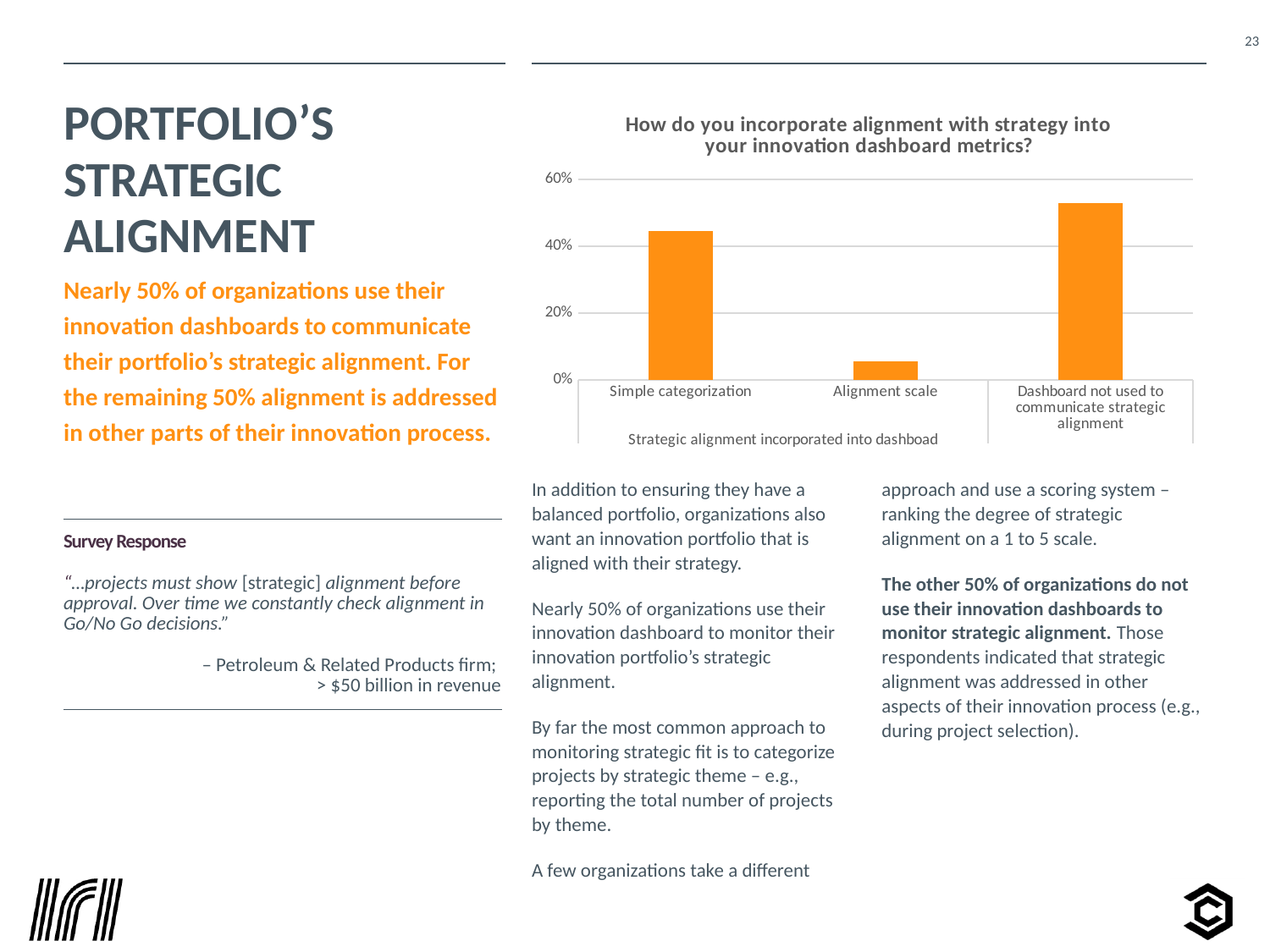
Which category has the highest value in the chart? Dashboard not used to communicate strategic alignment Is the value for Dashboard not used to communicate strategic alignment greater or less than 60%? less What is the title of the chart? How do you incorporate alignment with strategy into your innovation dashboard metrics? Which category has the lowest value in the chart? Alignment scale Is the value for Alignment scale greater or less than 20%? less Which is larger: the value for Simple categorization or the value for Alignment scale? Simple categorization Is the value for Dashboard not used to communicate strategic alignment greater or less than 40%? greater What kind of chart is shown on the slide? Bar chart How many categories are plotted in the chart? 3 What is the highest value shown on the chart's vertical axis? 60% Which is larger: the value for Dashboard not used to communicate strategic alignment or the value for Simple categorization? Dashboard not used to communicate strategic alignment